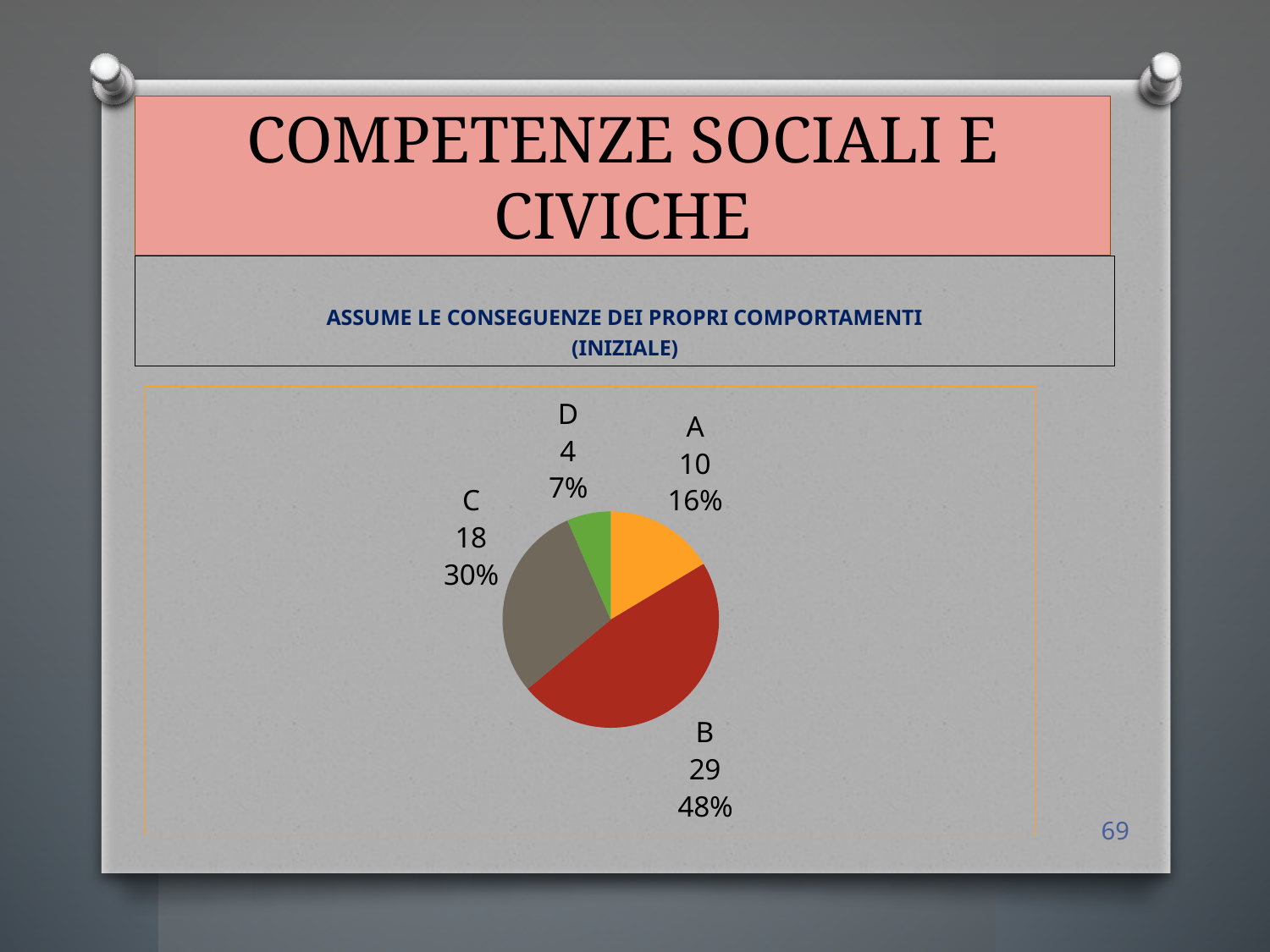
What is the difference between the values for B and C? 11 Which category has the smallest slice? D Which category has the largest slice? B What percentage share does category C have? 30% What is the value for category D? 4 How many slices does the pie chart have? 4 What colour is the slice for category D? green What is the total of all the values shown in the pie chart? 61 Which is larger, the value for A or the value for C? C What is the value for category B? 29 What kind of chart is shown on the slide? pie chart What percentage share does category A have? 16%